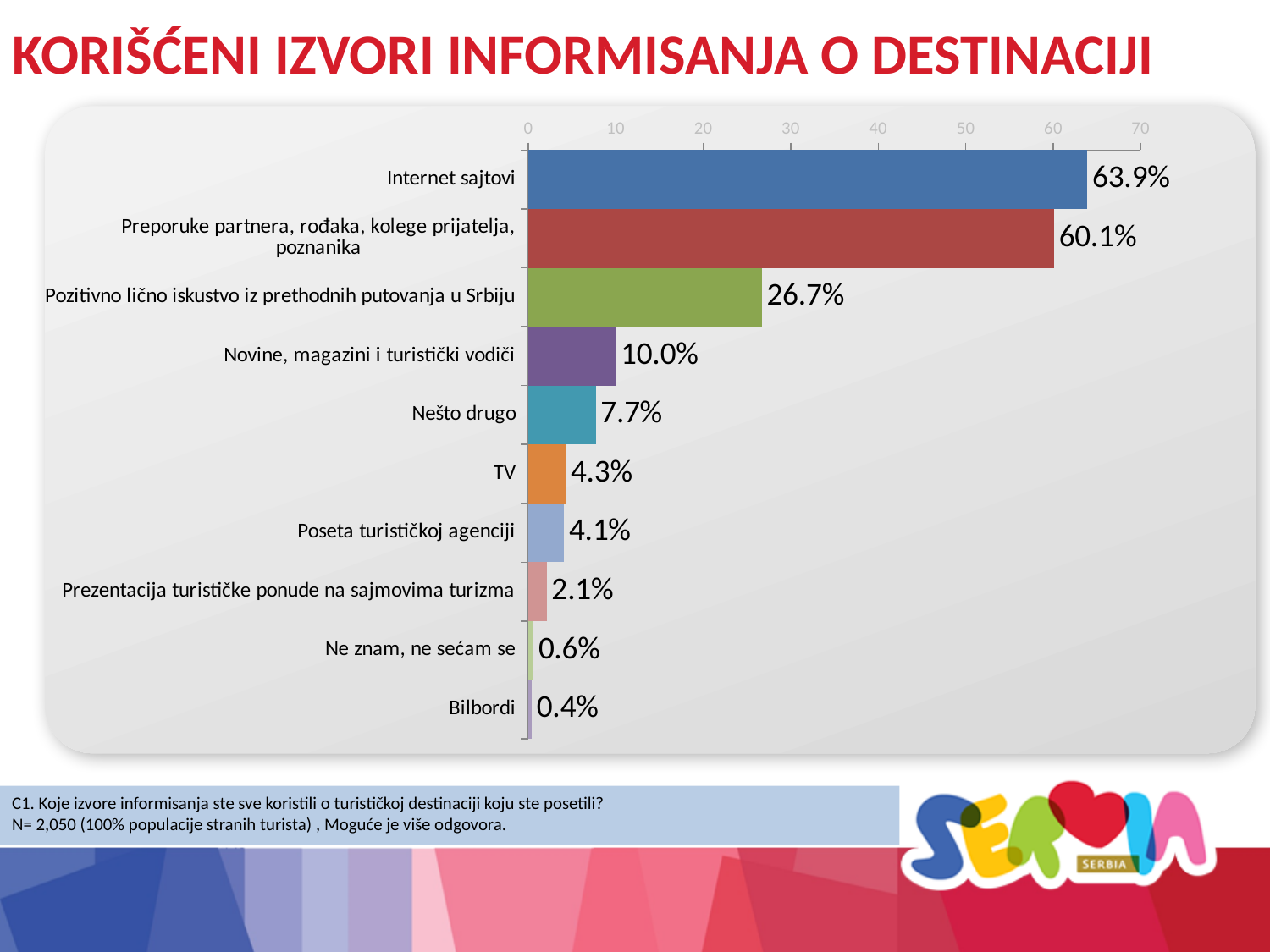
Which category has the lowest value? Bilbordi Which category has the highest value? Internet sajtovi What is the difference between the values for Nešto drugo and TV? 3.4% What kind of chart is shown on the slide? bar chart How many categories are shown in the chart? 10 What is the value for Internet sajtovi? 63.9% Is the value for Preporuke partnera, rođaka, kolege prijatelja, poznanika greater or less than 50? greater Which is larger, the value for Pozitivno lično iskustvo iz prethodnih putovanja u Srbiju or the value for Novine, magazini i turistički vodiči? Pozitivno lično iskustvo iz prethodnih putovanja u Srbiju What is the value for Poseta turističkoj agenciji? 4.1% What is the value for Novine, magazini i turistički vodiči? 10.0% What is the title of the slide? KORIŠĆENI IZVORI INFORMISANJA O DESTINACIJI What is the difference between the values for Internet sajtovi and Preporuke partnera, rođaka, kolege prijatelja, poznanika? 3.8%